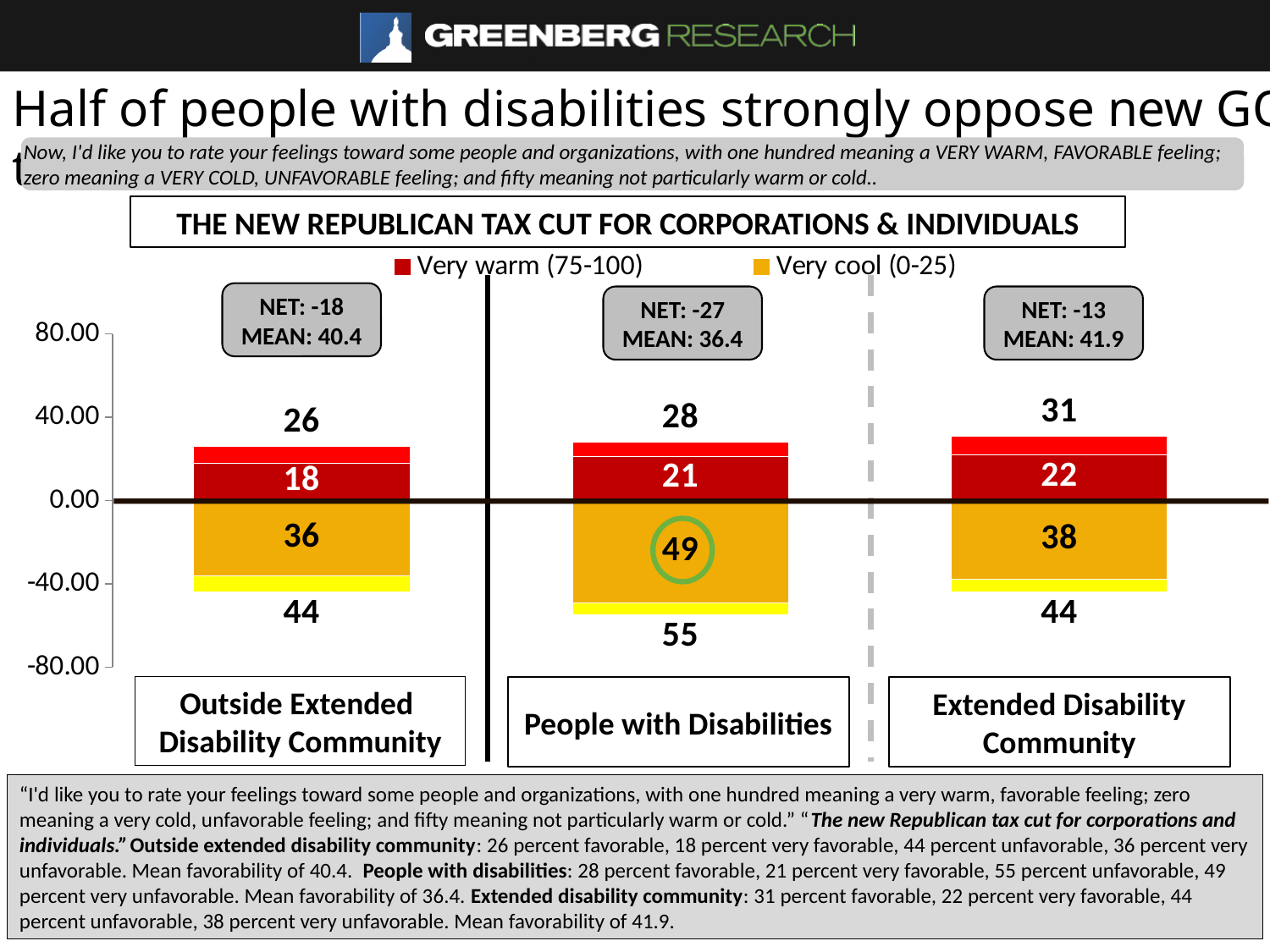
How many series does the chart legend list? 2 What is the 'Very warm (75-100)' value for People with Disabilities? 21 Which group has the highest 'Very cool (0-25)' value? People with Disabilities How many groups are shown on the x axis of the chart? 3 What kind of chart is shown on the slide? Bar chart Is the 'Very warm (75-100)' value larger for the Extended Disability Community or for the Outside Extended Disability Community? Extended Disability Community What is the MEAN value shown above the Extended Disability Community bar? 41.9 What is the 'Very cool (0-25)' value for the Extended Disability Community? 38 Which group has the lowest 'Very warm (75-100)' value? Outside Extended Disability Community What is the difference between the 'Very cool (0-25)' values for People with Disabilities and the Extended Disability Community? 11 What is the NET value shown above the People with Disabilities bar? -27 What is the 'Very cool (0-25)' value for the Outside Extended Disability Community? 36